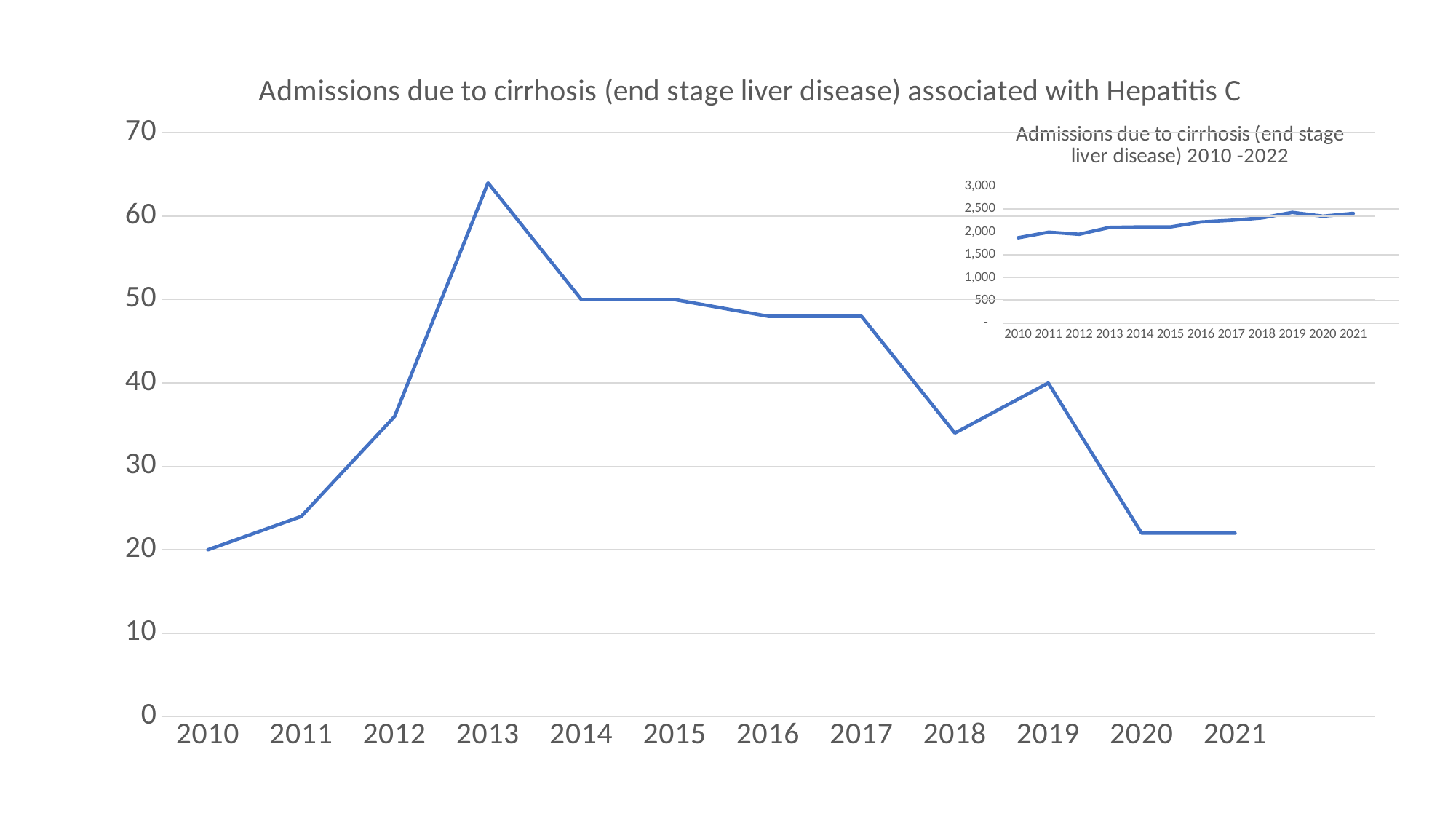
In the small inset chart 'Admissions due to cirrhosis (end stage liver disease) 2010 -2022', is the value for 2010 greater or less than 2,000? less In the large Hepatitis C chart, is the value for 2018 greater or less than 30? greater In the large Hepatitis C chart, is the value for 2020 greater or less than 30? less In the large Hepatitis C chart, which year has the larger value, 2011 or 2018? 2018 In the large Hepatitis C chart, how many years are plotted along the x axis? 12 What kind of chart is the large chart titled 'Admissions due to cirrhosis (end stage liver disease) associated with Hepatitis C'? line chart What kind of chart is the small inset chart titled 'Admissions due to cirrhosis (end stage liver disease) 2010 -2022'? line chart In the small inset chart 'Admissions due to cirrhosis (end stage liver disease) 2010 -2022', do the values generally rise or fall from 2010 to 2021? rise In the large Hepatitis C chart, which year has the highest number of admissions? 2013 In the large Hepatitis C chart, do the values rise or fall between 2010 and 2013? rise